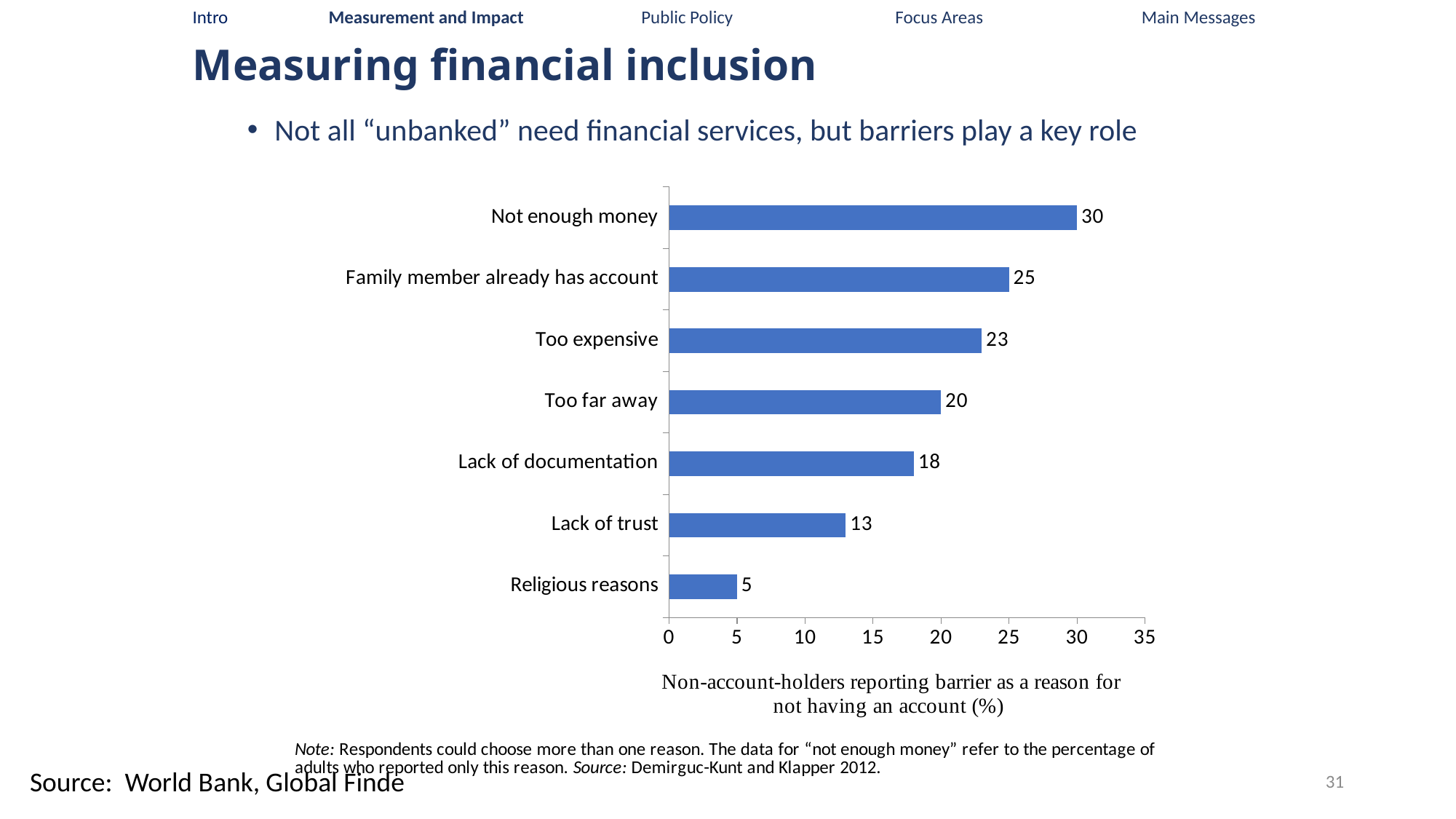
What is the difference between the values for "Too far away" and "Lack of trust"? 7 What is the value for "Not enough money"? 30 How many barriers are shown in the chart? 7 Is the value for "Lack of trust" greater or less than 15? less Which barrier has the highest value? Not enough money What is the value for "Religious reasons"? 5 What is the label on the horizontal axis of the chart? Non-account-holders reporting barrier as a reason for not having an account (%) Which is larger, the value for "Too expensive" or the value for "Too far away"? Too expensive What kind of chart is shown on the slide? bar chart What is the value for "Lack of documentation"? 18 What is the difference between the values for "Family member already has account" and "Too expensive"? 2 Which barrier has the lowest value? Religious reasons